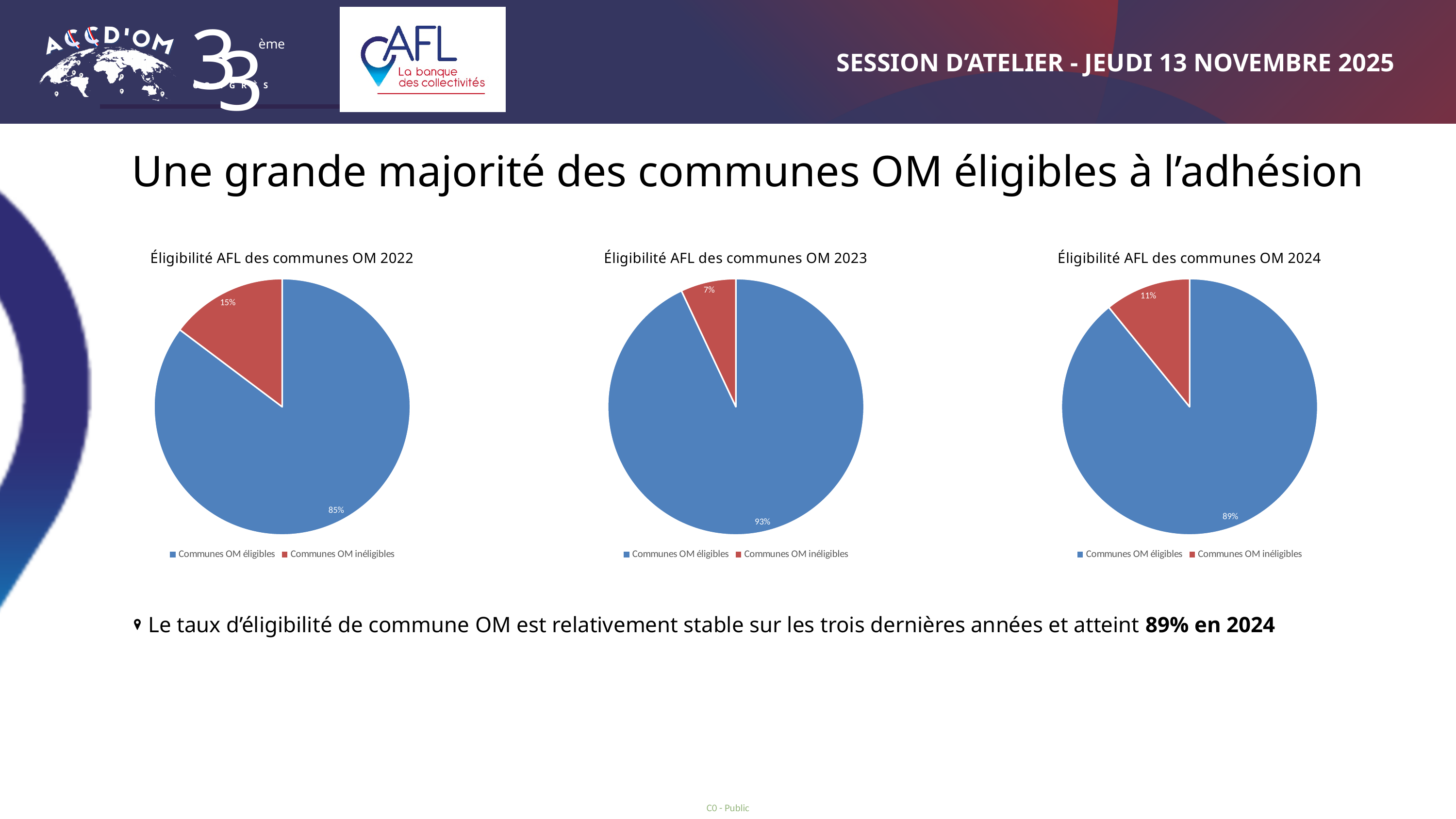
In the chart titled 'Éligibilité AFL des communes OM 2022', what share of the pie is 'Communes OM éligibles'? 85% In the chart titled 'Éligibilité AFL des communes OM 2023', what share of the pie is 'Communes OM éligibles'? 93% In the chart titled 'Éligibilité AFL des communes OM 2023', what share of the pie is 'Communes OM inéligibles'? 7% What kind of chart is the chart titled 'Éligibilité AFL des communes OM 2023'? Pie chart In the chart titled 'Éligibilité AFL des communes OM 2024', what colour is the 'Communes OM inéligibles' slice? Red How many slices does the chart titled 'Éligibilité AFL des communes OM 2022' have? 2 In the chart titled 'Éligibilité AFL des communes OM 2022', which slice is the largest? Communes OM éligibles In the chart titled 'Éligibilité AFL des communes OM 2024', what is the difference between the 'Communes OM éligibles' share and the 'Communes OM inéligibles' share? 78% In the chart titled 'Éligibilité AFL des communes OM 2023', which slice is the smallest? Communes OM inéligibles